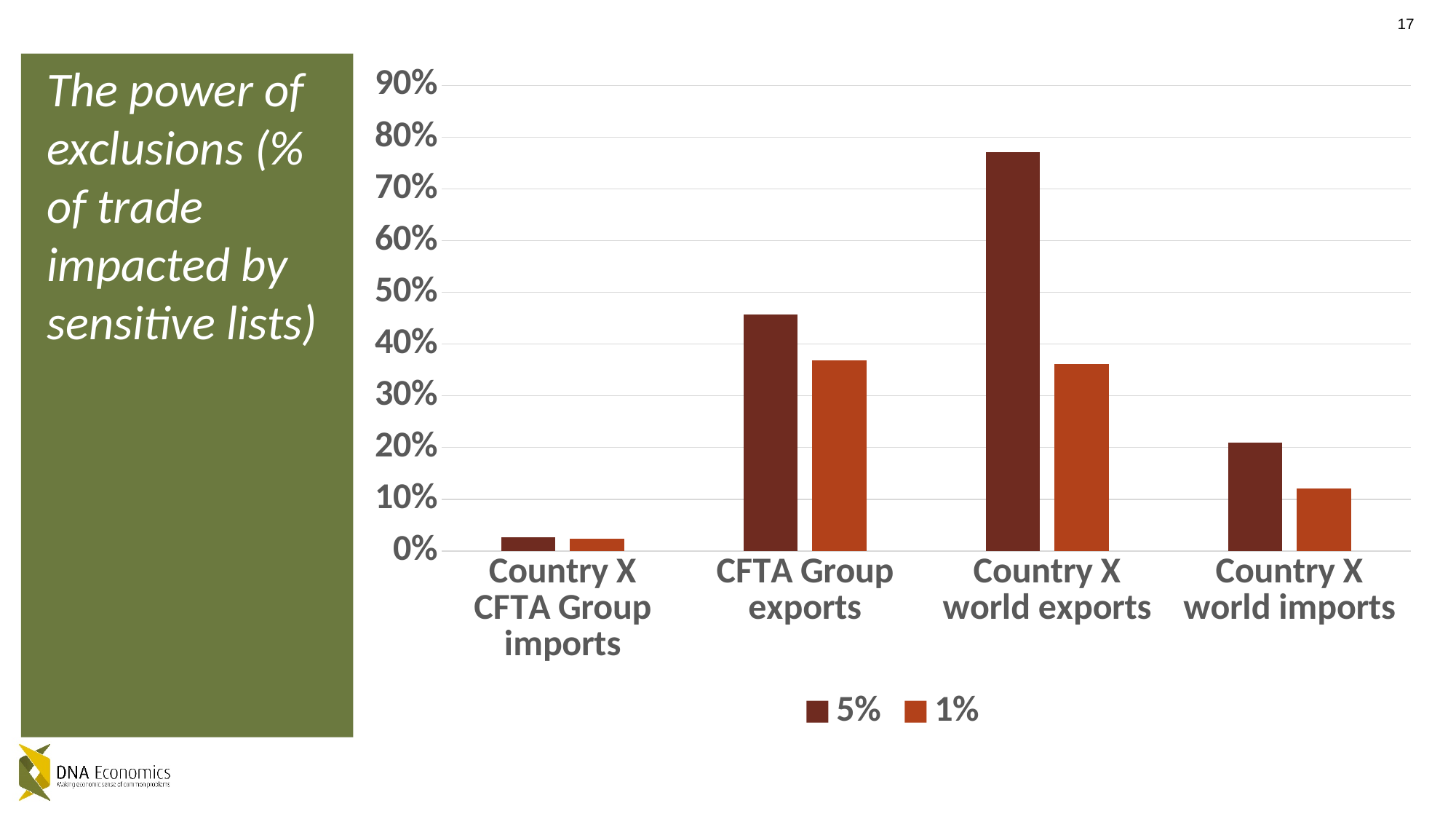
Is the 5% value for Country X world imports greater or less than 20%? greater How many categories are shown on the x axis of the chart? 4 Is the 1% value for Country X world imports greater or less than 10%? greater Is the 1% value for CFTA Group exports greater or less than 40%? less Which category has the lowest value for the 1% series? Country X CFTA Group imports How many series does the chart's legend list? 2 Which category has the highest value for the 5% series? Country X world exports What are the two series names listed in the chart's legend? 5% and 1% For Country X world exports, which series has the larger value, 5% or 1%? 5% Which category has the lowest value for the 5% series? Country X CFTA Group imports What kind of chart is shown on the slide? bar chart